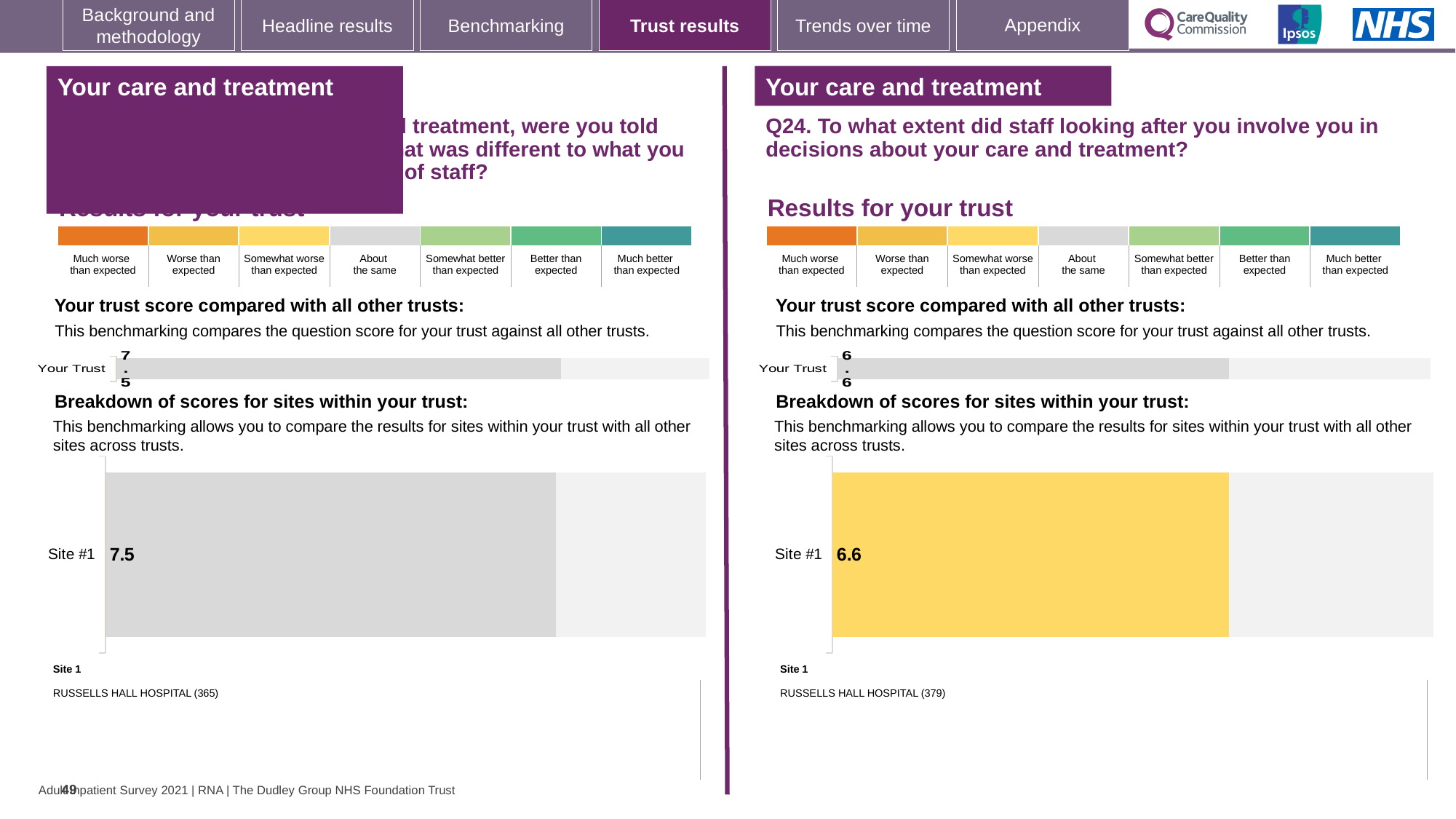
In the site breakdown chart on the right (Q24), what is the score for Site #1? 6.6 How many sites are shown in the site breakdown chart on the left? 1 Which hospital is listed as Site 1 under the right-hand (Q24) chart? RUSSELLS HALL HOSPITAL (379) What is the difference between the Site #1 score on the left-hand chart and the Site #1 score on the right-hand (Q24) chart? 0.9 How many sites are shown in the site breakdown chart on the right (Q24)? 1 On the right-hand chart (Q24), what is the score shown for Your Trust? 6.6 On the left-hand chart, what is the score shown for Your Trust? 7.5 Which is larger: the Site #1 score in the left-hand breakdown chart or the Site #1 score in the right-hand (Q24) breakdown chart? Left-hand chart (7.5) What colour is the Site #1 bar in the right-hand (Q24) site breakdown chart? Yellow In the site breakdown chart on the left, what is the score for Site #1? 7.5 What type of chart is used for the site breakdown on the right (Q24)? Bar chart